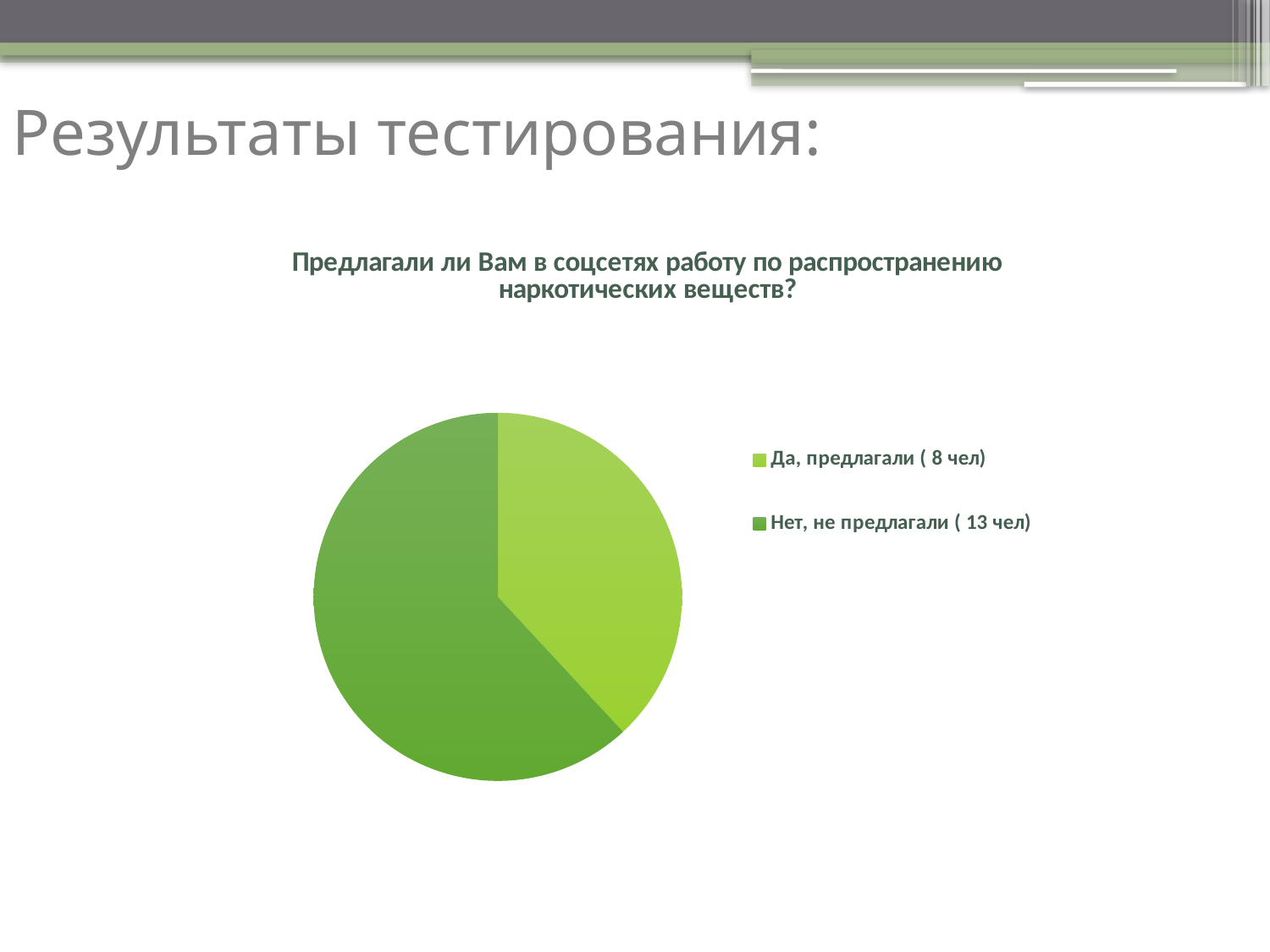
What is the title of the pie chart? Предлагали ли Вам в соцсетях работу по распространению наркотических веществ? Which legend entry is shown in the lighter green colour? Да, предлагали ( 8 чел) How many people answered "Нет, не предлагали"? 13 чел Which answer has the smaller slice of the pie? Да, предлагали How many people answered "Да, предлагали"? 8 чел How many more people answered "Нет, не предлагали" than "Да, предлагали"? 5 Which is larger: the number who answered "Да, предлагали" or the number who answered "Нет, не предлагали"? Нет, не предлагали What is the total number of respondents shown in the pie chart? 21 How many slices does the pie chart have? 2 How many entries does the legend list? 2 Which answer has the larger slice of the pie? Нет, не предлагали What kind of chart is shown on the slide? pie chart